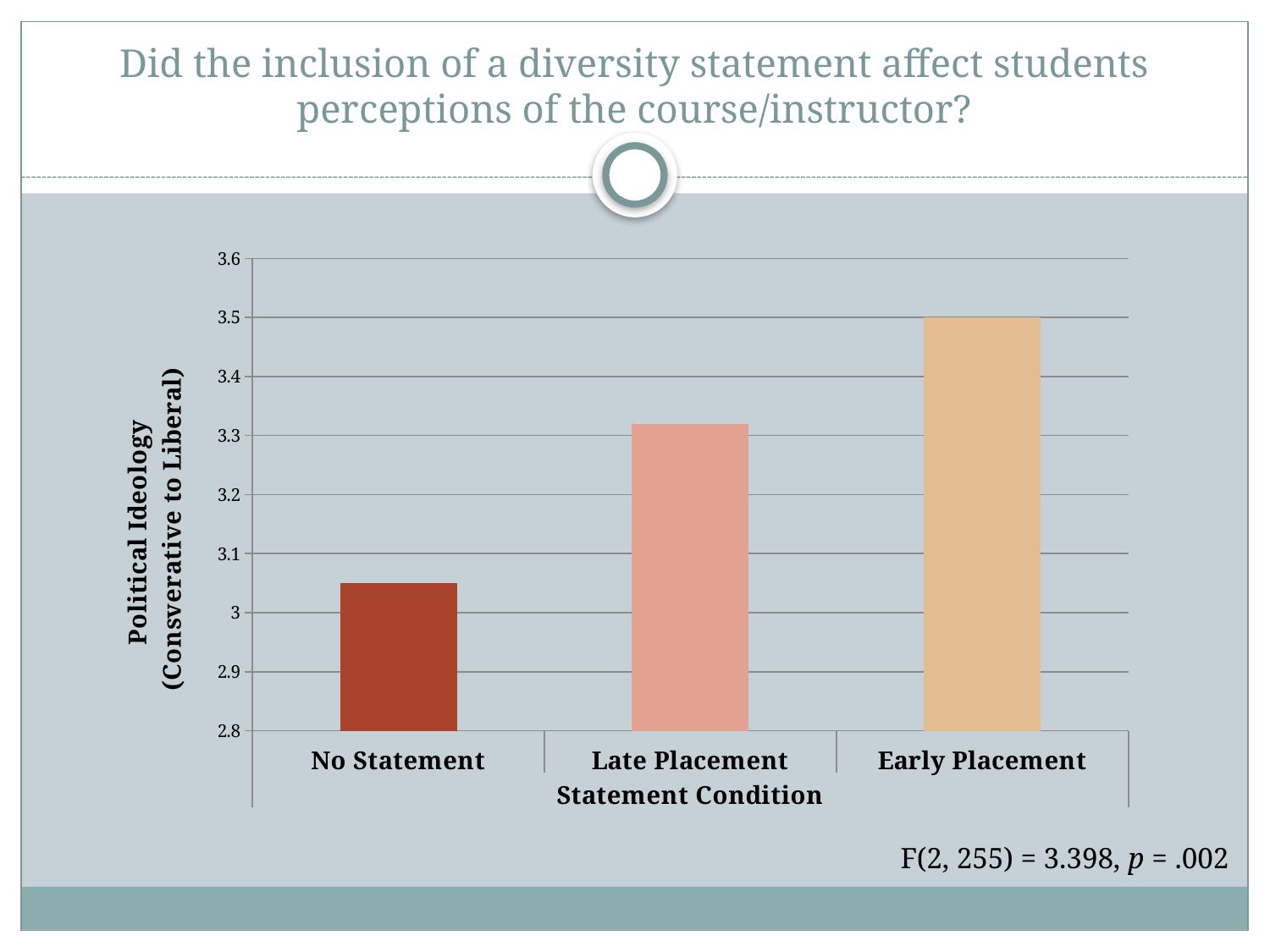
What is the title of the horizontal axis? Statement Condition Which statement condition has the highest political ideology value? Early Placement Is the value for Late Placement greater or less than 3.2? greater Which is larger, the value for Late Placement or the value for No Statement? Late Placement What is the title of the vertical axis? Political Ideology (Consverative to Liberal) How many statement conditions are shown on the x axis? 3 Which statement condition has the lowest political ideology value? No Statement Do the values rise or fall moving from No Statement to Early Placement along the x axis? rise Is the value for No Statement greater or less than 3.1? less What kind of chart is shown on the slide? bar chart Is the value for Late Placement greater or less than 3.4? less